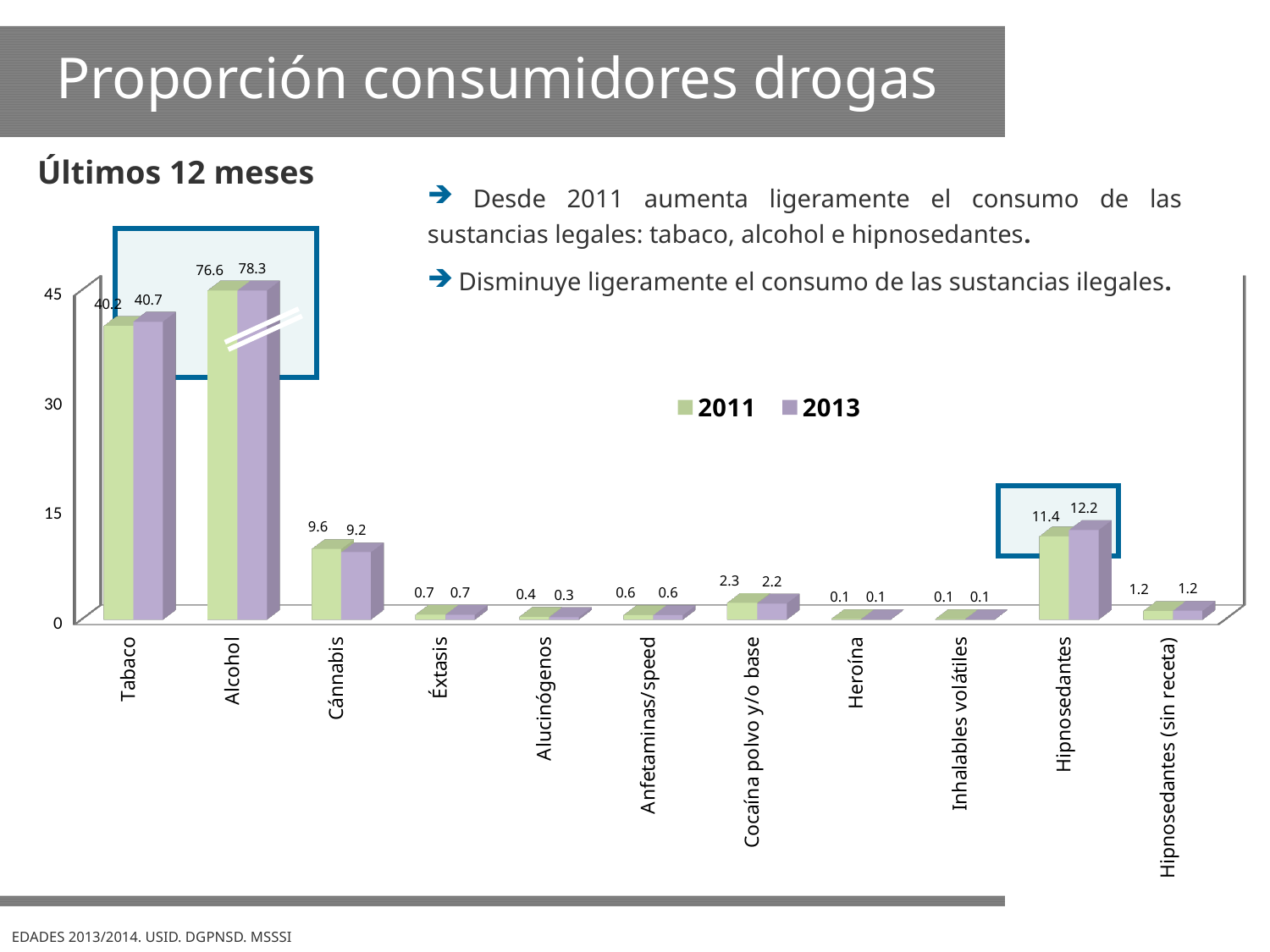
What is the 2013 value for Cánnabis? 9.2 Which category has the highest 2013 value? Alcohol Which is larger for Cánnabis, the 2011 value or the 2013 value? 2011 Which is larger for Tabaco, the 2011 value or the 2013 value? 2013 What is the difference between the 2013 and 2011 values for Alcohol? 1.7 How many categories are shown on the x axis? 11 What is the 2013 value for Alcohol? 78.3 What is the difference between the 2013 and 2011 values for Hipnosedantes? 0.8 What is the 2011 value for Hipnosedantes? 11.4 How many series does the legend list? 2 What kind of chart is shown on the slide? Bar chart What are the two series named in the legend? 2011 and 2013